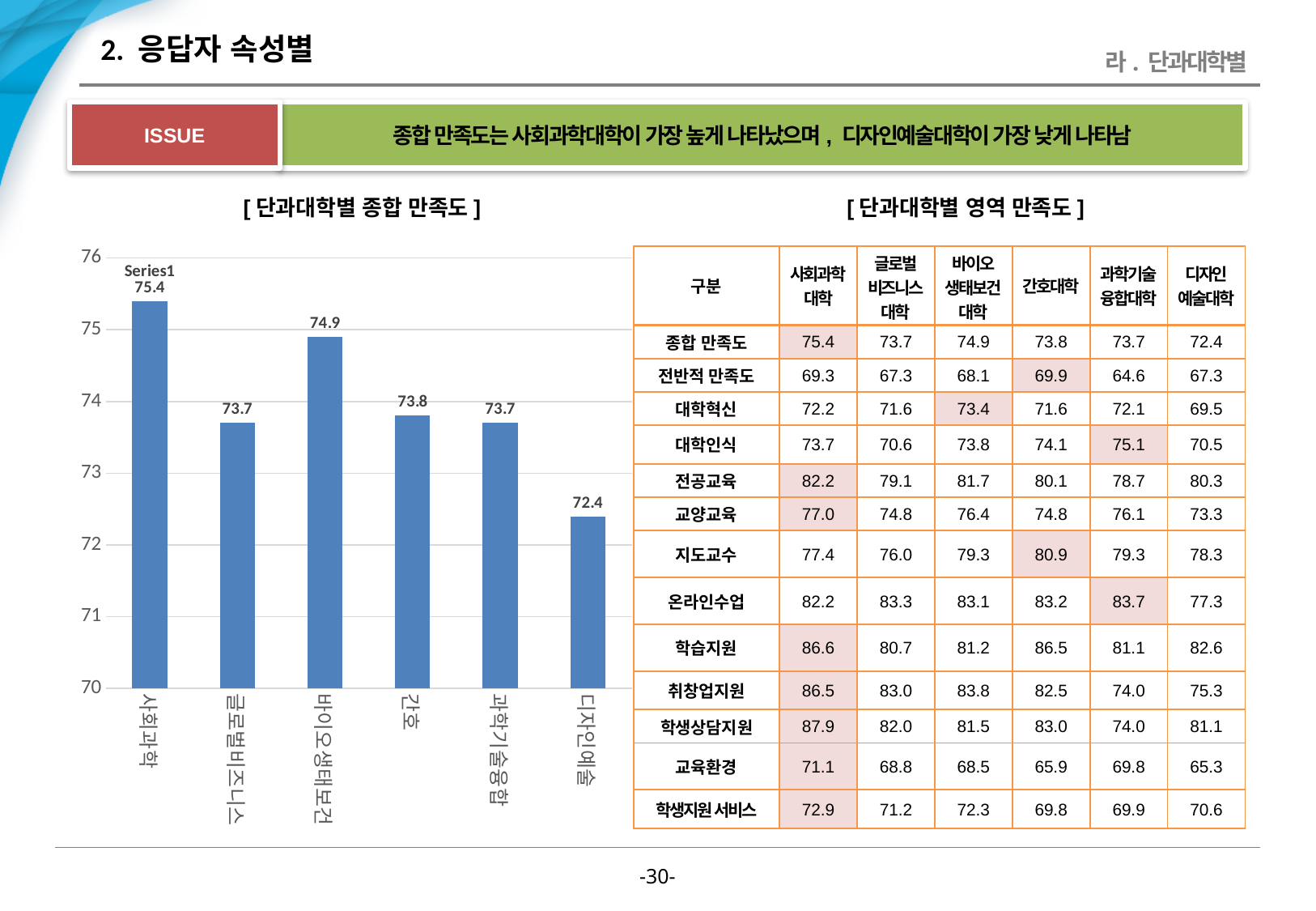
What is the value for 바이오생태보건 in the bar chart? 74.9 What is the difference between the values for 사회과학 and 디자인예술 in the bar chart? 3.0 What is the title of the chart on the left of the slide? [ 단과대학별 종합 만족도 ] Which category has the lowest value in the bar chart? 디자인예술 Is the value for 디자인예술 in the bar chart greater or less than 73? less How many categories are shown in the bar chart? 6 What kind of chart is shown on the left of the slide? bar chart What is the value for 디자인예술 in the bar chart? 72.4 What is the value for 사회과학 in the bar chart? 75.4 What is the difference between the values for 바이오생태보건 and 간호 in the bar chart? 1.1 Which is larger in the bar chart, the value for 바이오생태보건 or the value for 간호? 바이오생태보건 Which category has the highest value in the bar chart? 사회과학